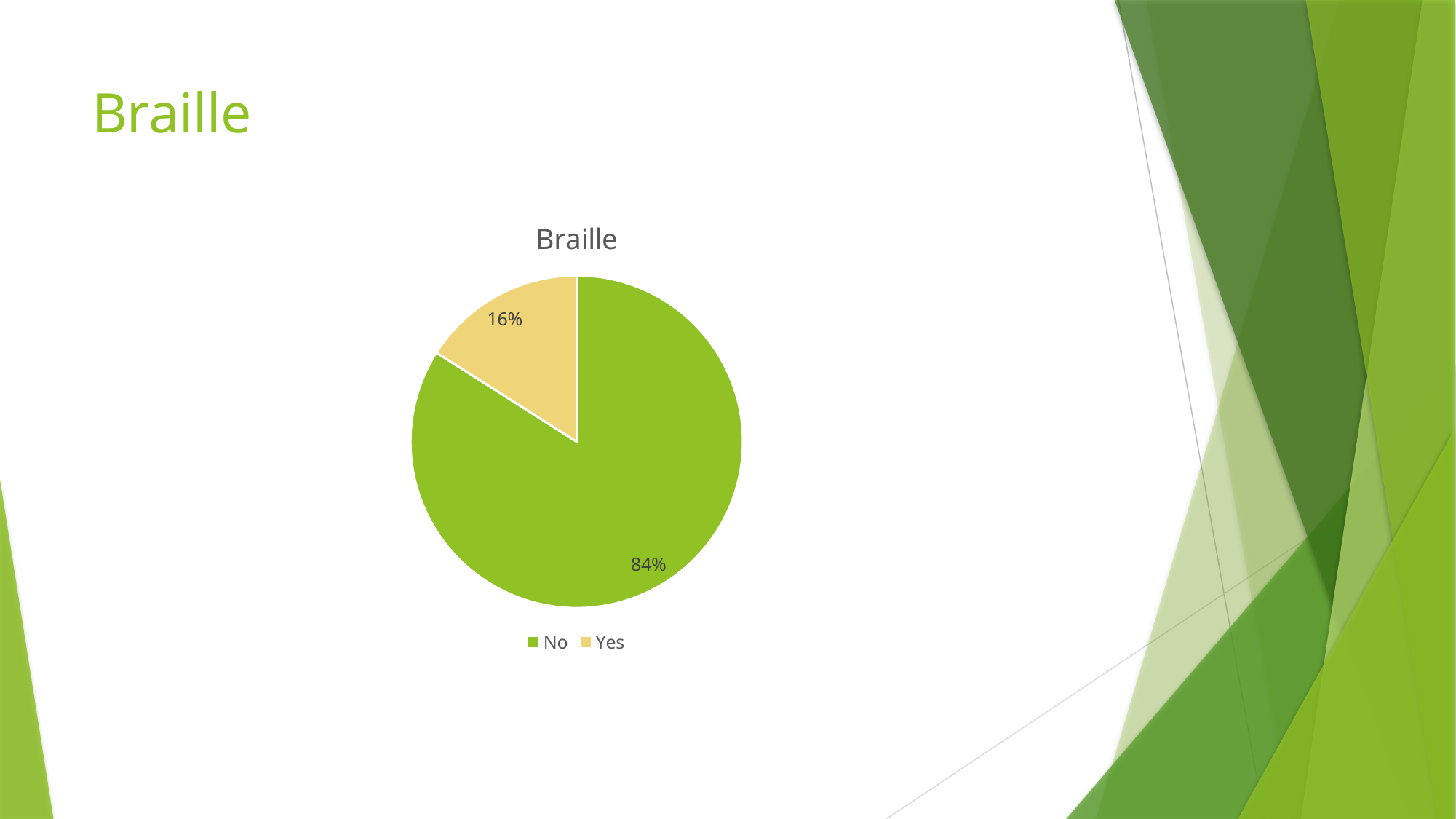
What is the title of the chart? Braille What percentage of the pie is labelled "Yes"? 16% What share of the pie does the "Yes" slice represent? 16% Which is larger, the "Yes" slice or the "No" slice? No What is the difference in percentage points between the "No" and "Yes" slices? 68 How many slices does the pie chart have? 2 What percentage of the pie is labelled "No"? 84% What type of chart is shown on the slide? pie chart Which category has the largest share of the pie? No How many entries does the legend list? 2 Which category has the smallest share of the pie? Yes What colour is the "Yes" slice? yellow